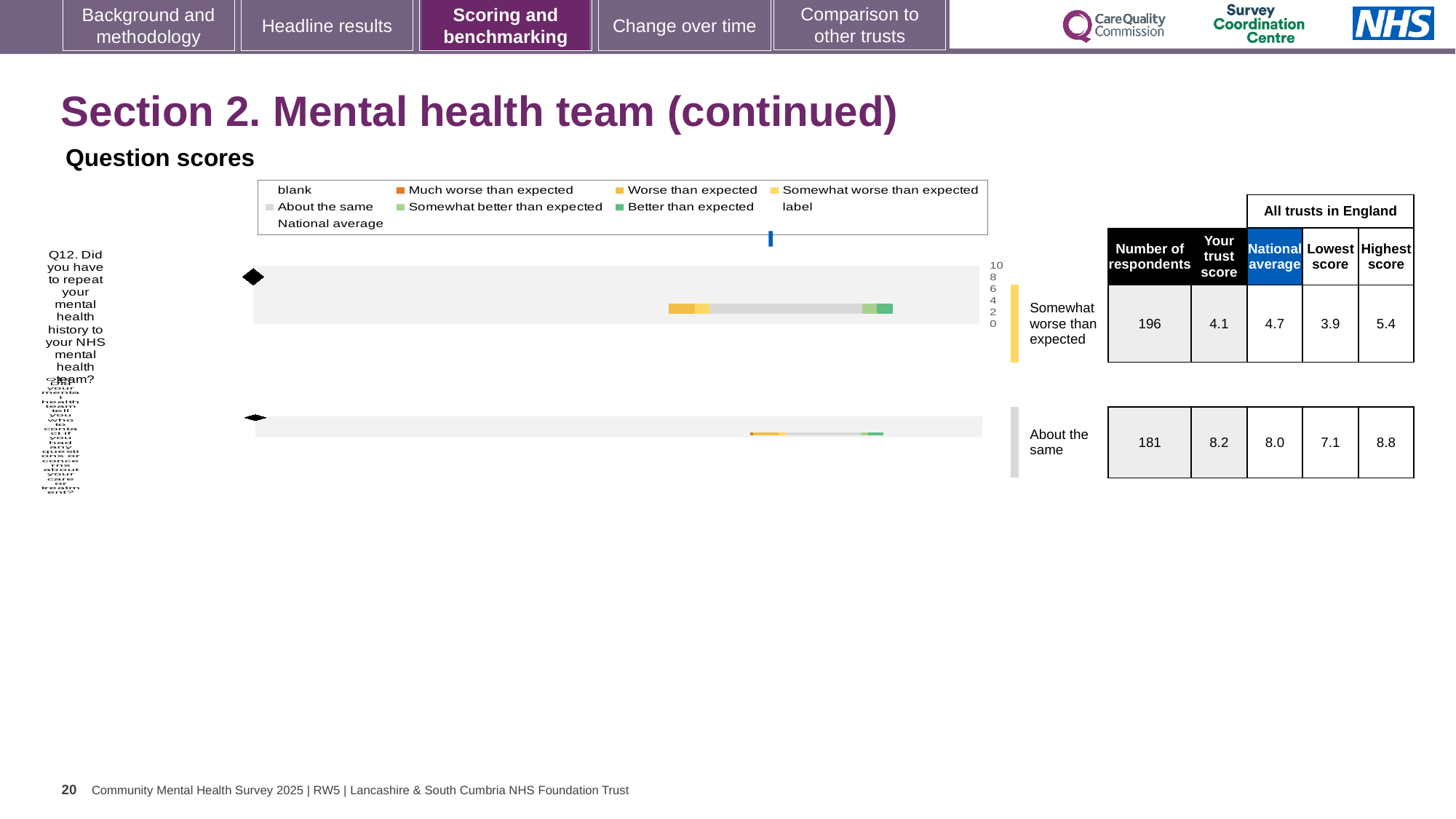
What is the lowest score among all trusts in England for Q12? 3.9 How many respondents answered Q12? 196 What is the difference between the national average and the trust score for Q12? 0.6 What is the national average score for Q12? 4.7 Which benchmark category is Q12 placed in? Somewhat worse than expected What colour does the legend use for 'Much worse than expected'? orange What is the trust score for Q12 (repeating mental health history to the NHS mental health team)? 4.1 What is the highest score among all trusts in England for Q12? 5.4 What is the maximum value shown on the chart's score axis? 10 Is the trust score for Q12 higher or lower than the national average? lower What kind of chart is used to show the question scores on this slide? bar chart What is the difference between the highest and lowest scores for Q12 across all trusts in England? 1.5